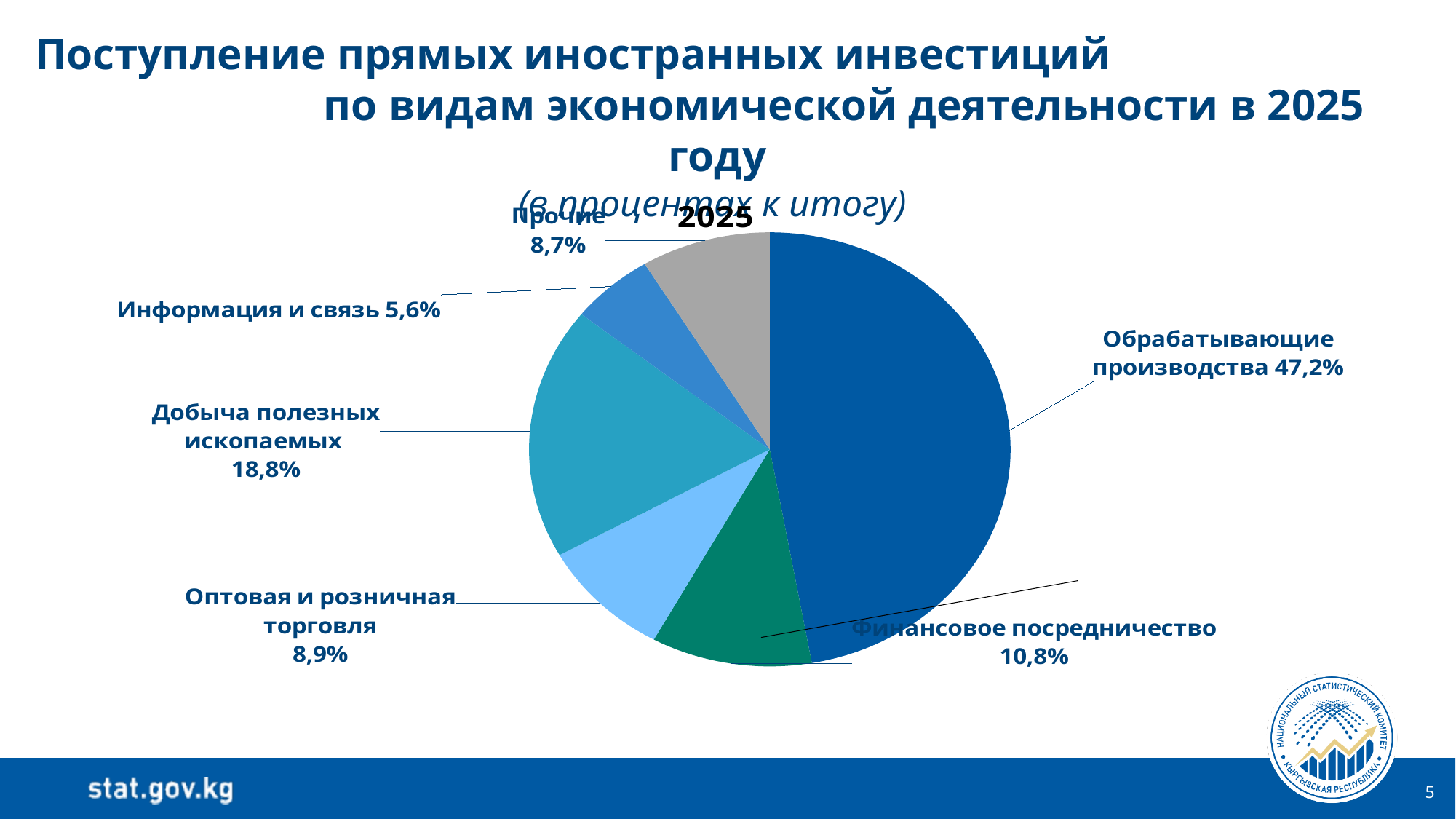
What is the value for Информация и связь? 5,6% What is the difference between Финансовое посредничество and Оптовая и розничная торговля? 1,9% Which category has the smallest slice of the pie? Информация и связь What is the value shown for Добыча полезных ископаемых? 18,8% What type of chart is shown on the slide? Pie chart Which category has the largest slice of the pie? Обрабатывающие производства What is the title shown above the pie chart? 2025 What percentage is shown for Финансовое посредничество? 10,8% What is the difference between the shares of Обрабатывающие производства and Добыча полезных ископаемых? 28,4% Which is larger: Финансовое посредничество or Оптовая и розничная торговля? Финансовое посредничество What share of the pie does Обрабатывающие производства have? 47,2% How many slices does the pie chart have? 6